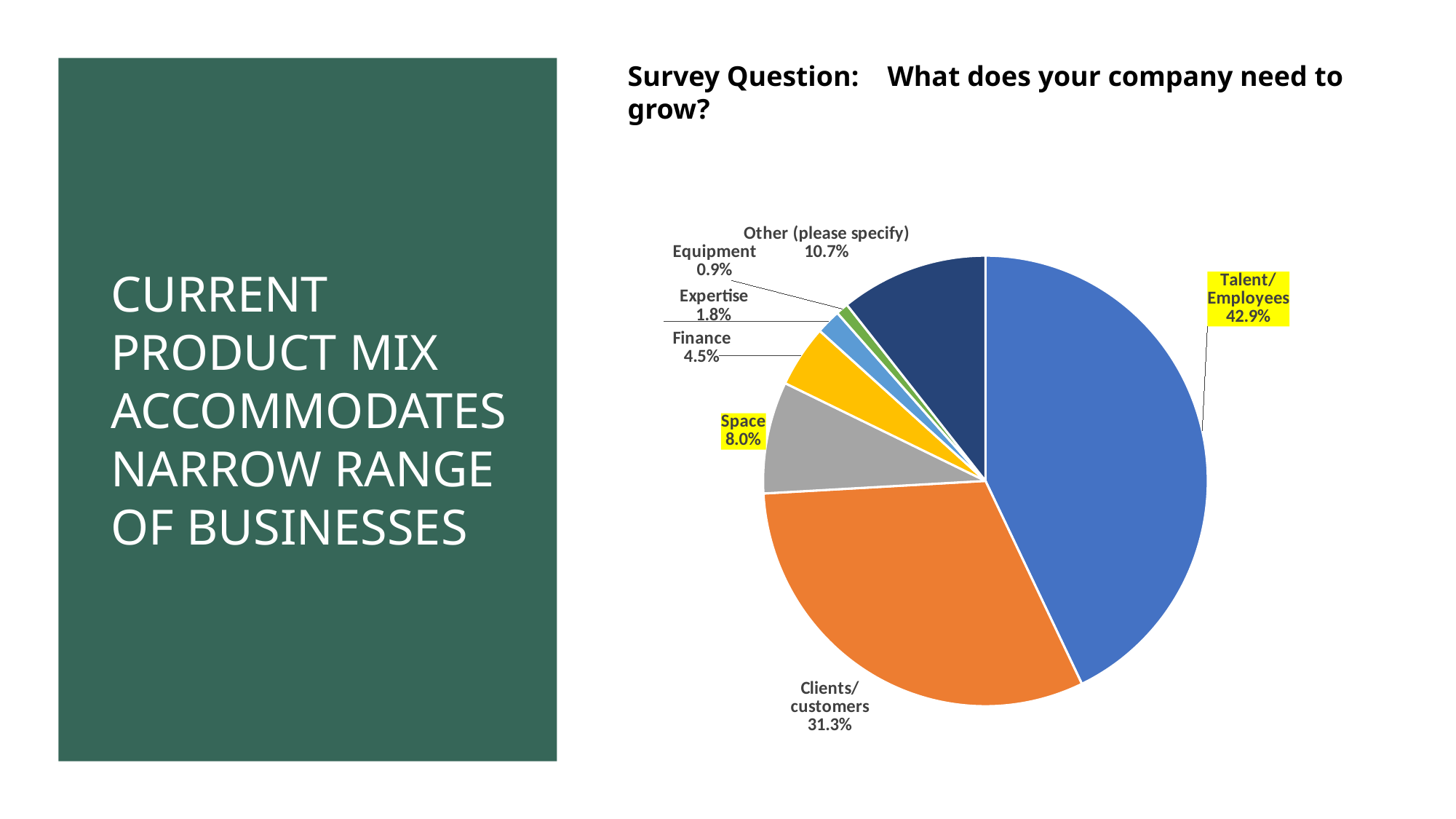
What percentage of the pie is Talent/Employees? 42.9% Which category has the largest slice of the pie? Talent/Employees What kind of chart is shown on the slide? pie chart What is the difference between the Talent/Employees share and the Clients/customers share? 11.6% What percentage of the pie is Finance? 4.5% What percentage of the pie is Equipment? 0.9% How many slices does the pie chart have? 7 What survey question is the pie chart based on? What does your company need to grow? What percentage of the pie is Clients/customers? 31.3% Which is larger, the Space slice or the Finance slice? Space Which category has the smallest slice of the pie? Equipment What percentage of the pie is Space? 8.0%